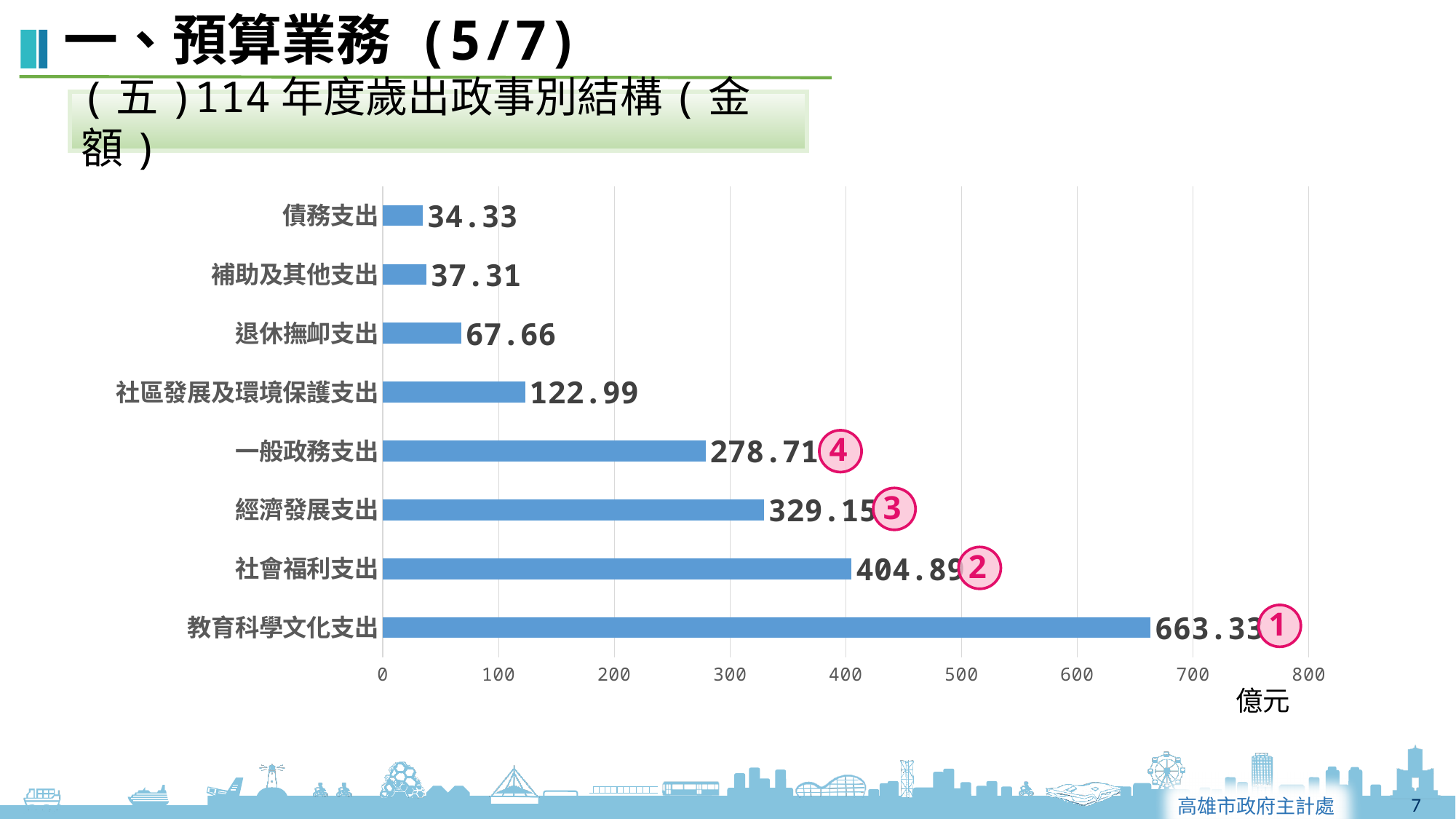
Which is larger, 一般政務支出 or 經濟發展支出? 經濟發展支出 What kind of chart is shown on the slide? bar chart What is the value for 教育科學文化支出? 663.33 What is the value for 社區發展及環境保護支出? 122.99 How many categories are shown in the chart? 8 Which category has the highest value? 教育科學文化支出 Which category has the lowest value? 債務支出 Is the value for 一般政務支出 greater or less than 300? less What is the difference between 社會福利支出 and 經濟發展支出? 75.74 What is the difference between 教育科學文化支出 and 社會福利支出? 258.44 What unit is shown at the end of the x axis? 億元 What is the value for 退休撫卹支出? 67.66